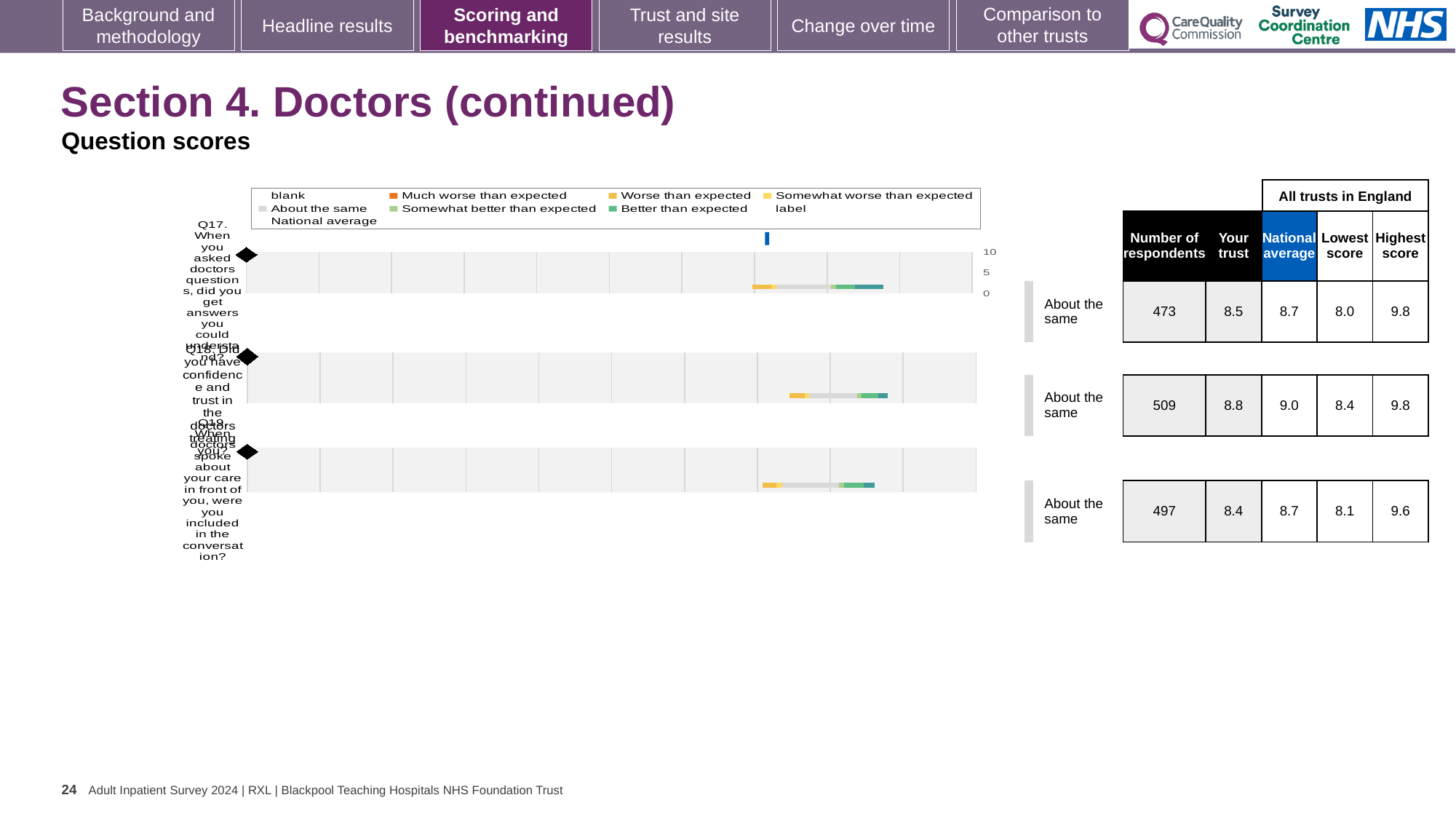
Which question has the largest number of respondents in the table beside the chart? Q18 How many questions (categories) are plotted in the chart? 3 For Q18, what is the difference between the national average and the 'Your trust' score? 0.2 In the table beside the chart, what is the highest score across all trusts in England for Q19? 9.6 Which colour does the legend use for 'Much worse than expected'? orange In the table beside the chart, what is the national average for Q19? 8.7 What kind of chart is used to show the question scores for Q17, Q18 and Q19? bar chart For Q17, which is larger: the 'Your trust' score or the national average? National average In the table beside the chart, what is the number of respondents for Q17? 473 In the table beside the chart, what is the 'Your trust' score for Q18? 8.8 What benchmark category is shown for Q19 next to the chart? About the same What is the highest tick value shown on the chart's score axis? 10